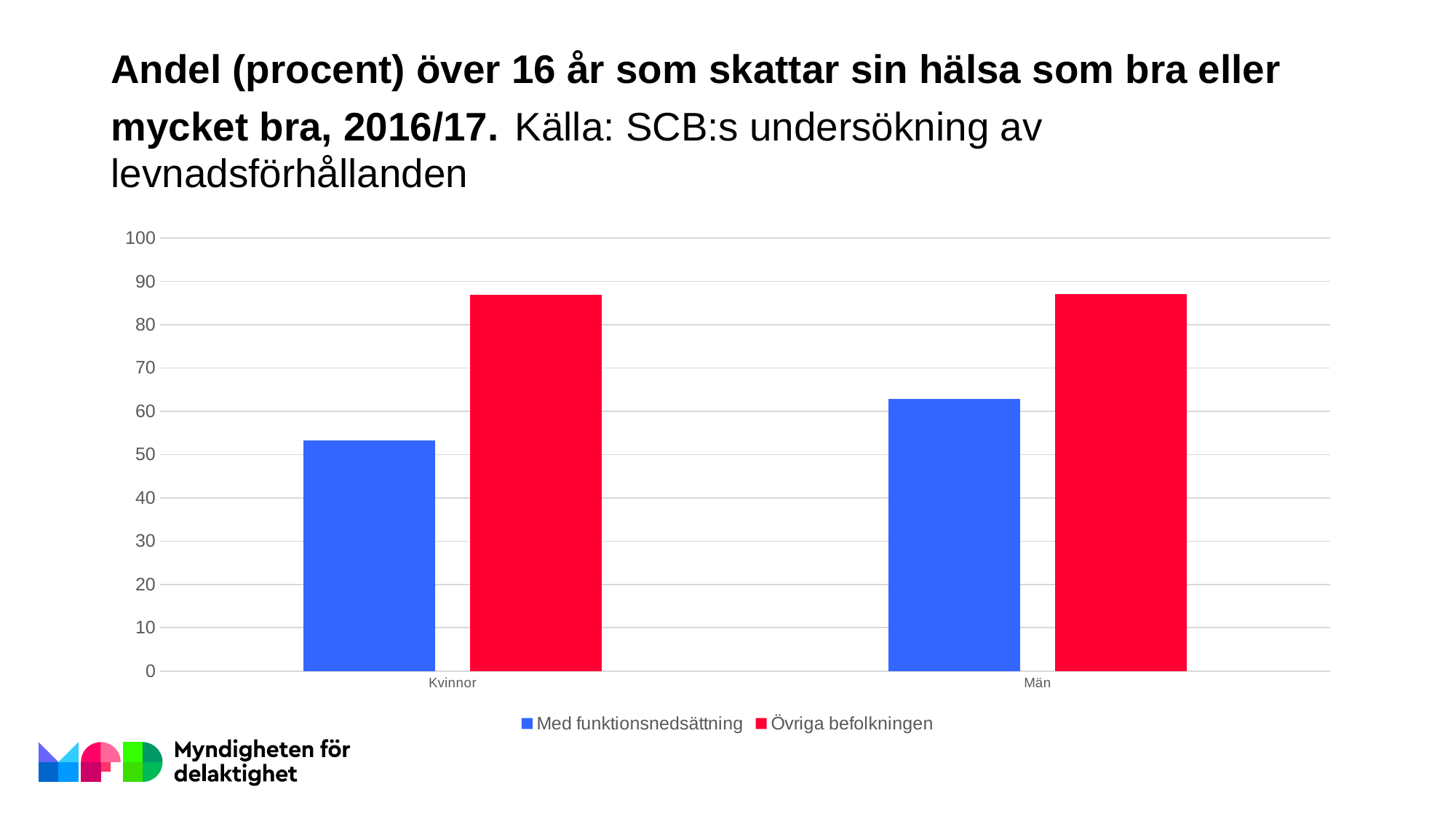
Which colour represents Övriga befolkningen in the chart? red Is the value for Med funktionsnedsättning among Män greater or less than 70? less Is the value for Med funktionsnedsättning among Kvinnor greater or less than 50? greater Which is larger for Kvinnor: Med funktionsnedsättning or Övriga befolkningen? Övriga befolkningen Is the value for Med funktionsnedsättning among Kvinnor greater or less than 60? less Which category has the higher value for Med funktionsnedsättning, Kvinnor or Män? Män How many categories are shown on the x axis? 2 What kind of chart is shown on the slide? bar chart How many series does the legend list? 2